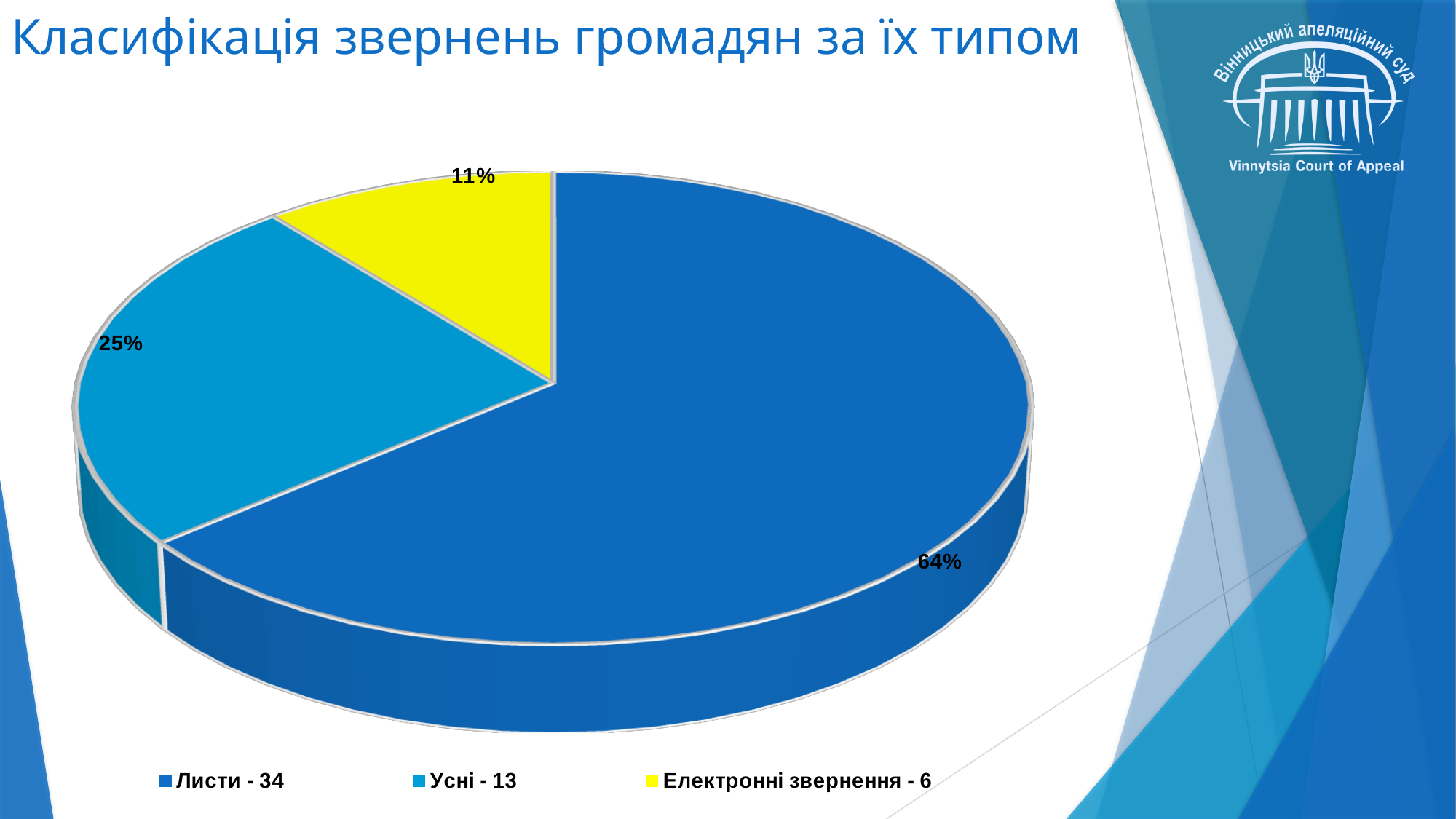
What percentage share does the "Листи - 34" slice have? 64% What kind of chart is shown on the slide? pie chart How many slices does the pie chart have? 3 How many entries does the legend list? 3 Which slice is larger, "Усні - 13" or "Електронні звернення - 6"? Усні - 13 What colour is the "Електронні звернення - 6" slice? yellow Which category has the smallest slice of the pie? Електронні звернення - 6 What is the difference in percentage points between the "Листи - 34" slice and the "Усні - 13" slice? 39 Which category has the largest slice of the pie? Листи - 34 What percentage share does the "Електронні звернення - 6" slice have? 11% What is the title of the slide? Класифікація звернень громадян за їх типом What percentage share does the "Усні - 13" slice have? 25%